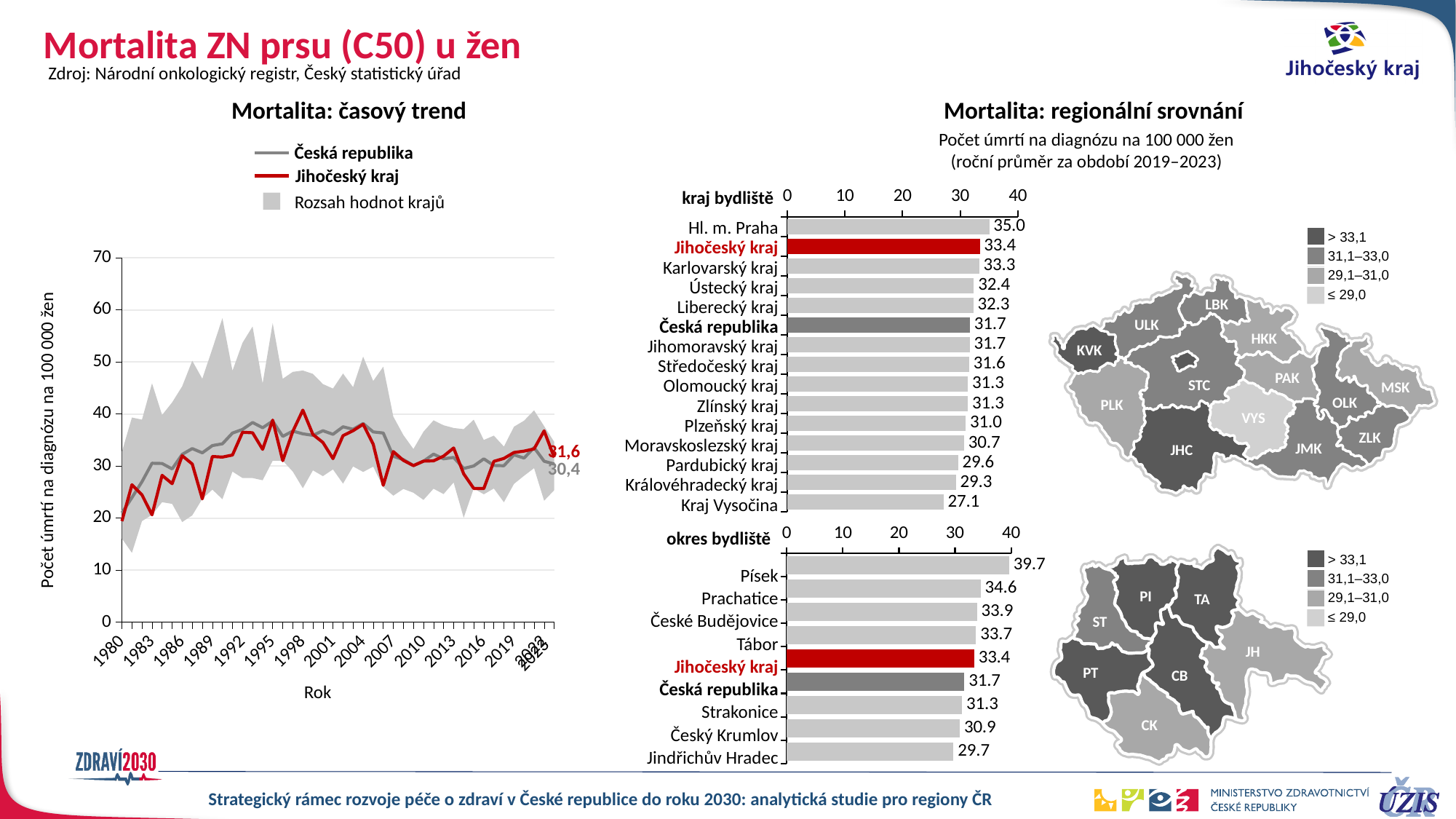
In the 'Mortalita: časový trend' chart, what is the final labelled value for Česká republika? 30,4 In the 'Mortalita: časový trend' chart, what is the final labelled value for Jihočeský kraj? 31,6 In the 'kraj bydliště' bar chart, how many bars are plotted? 15 In the 'okres bydliště' bar chart, which district has the highest value? Písek In the 'kraj bydliště' bar chart, which region has the lowest value? Kraj Vysočina In the 'okres bydliště' bar chart, which is larger: Prachatice or Tábor? Prachatice In the 'okres bydliště' bar chart, what is the value for Jindřichův Hradec? 29.7 What kind of chart is 'Mortalita: časový trend'? combination area and line chart (lines with a shaded area range) In the 'kraj bydliště' bar chart, what is the difference between Jihočeský kraj and Česká republika? 1.7 In the 'okres bydliště' bar chart, how many bars are plotted? 9 In the 'kraj bydliště' bar chart, what is the value for Hl. m. Praha? 35.0 In the 'okres bydliště' bar chart, what is the difference between Písek and Český Krumlov? 8.8